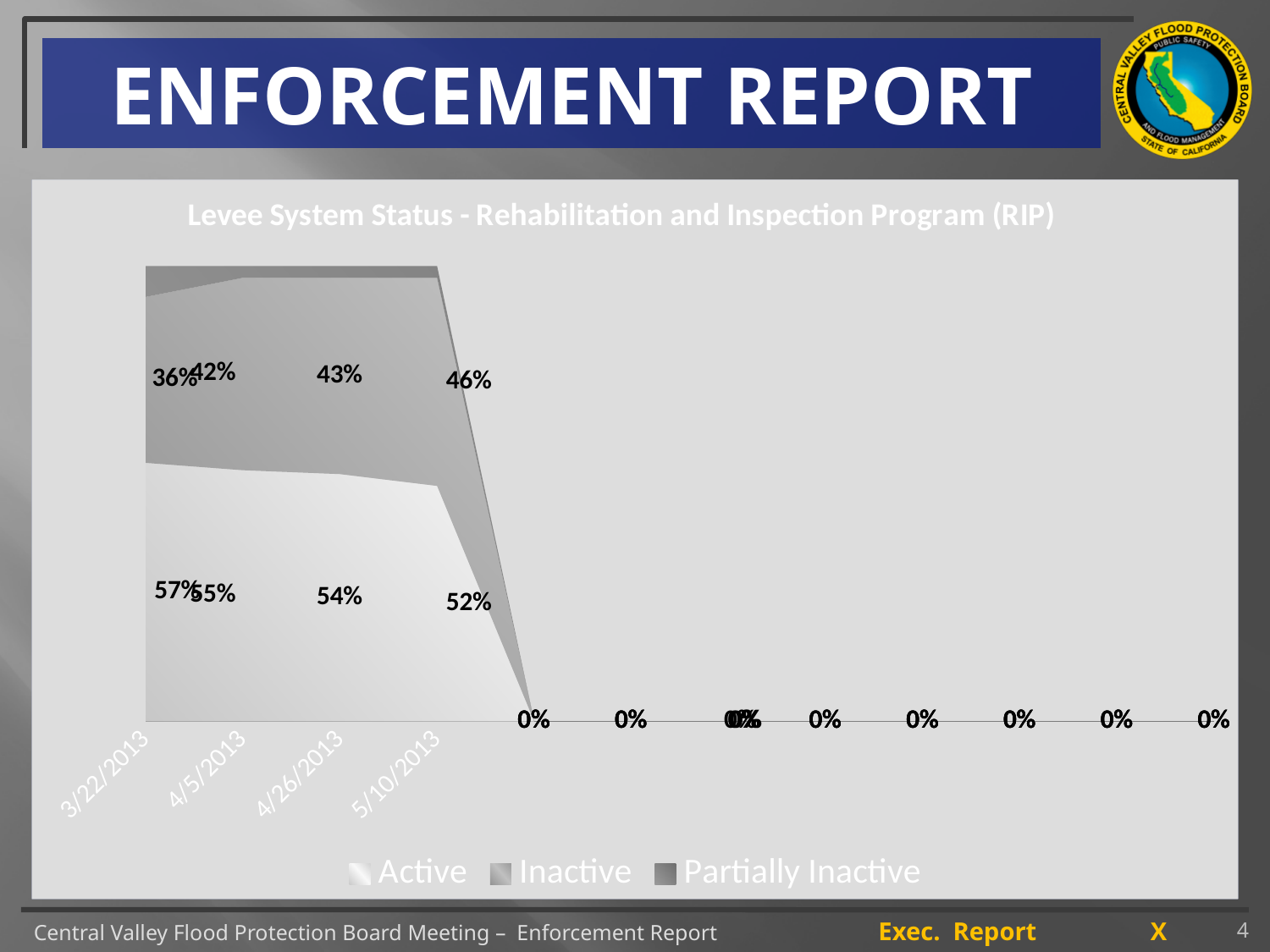
Which series are listed in the chart legend? Active, Inactive, Partially Inactive What kind of chart is shown on the slide? Stacked area chart On which labeled date is the Active value highest? 3/22/2013 Does the Active series rise or fall from 3/22/2013 to 5/10/2013? Fall What is the title of the chart? Levee System Status - Rehabilitation and Inspection Program (RIP) What is the Active value on 5/10/2013? 52% What is the Active value on 3/22/2013? 57% On which labeled date is the Inactive value lowest? 3/22/2013 How many series does the chart legend list? 3 What is the difference between the Active value on 3/22/2013 and on 5/10/2013? 5 percentage points What is the Inactive value on 4/26/2013? 43% What is the Inactive value on 5/10/2013? 46%